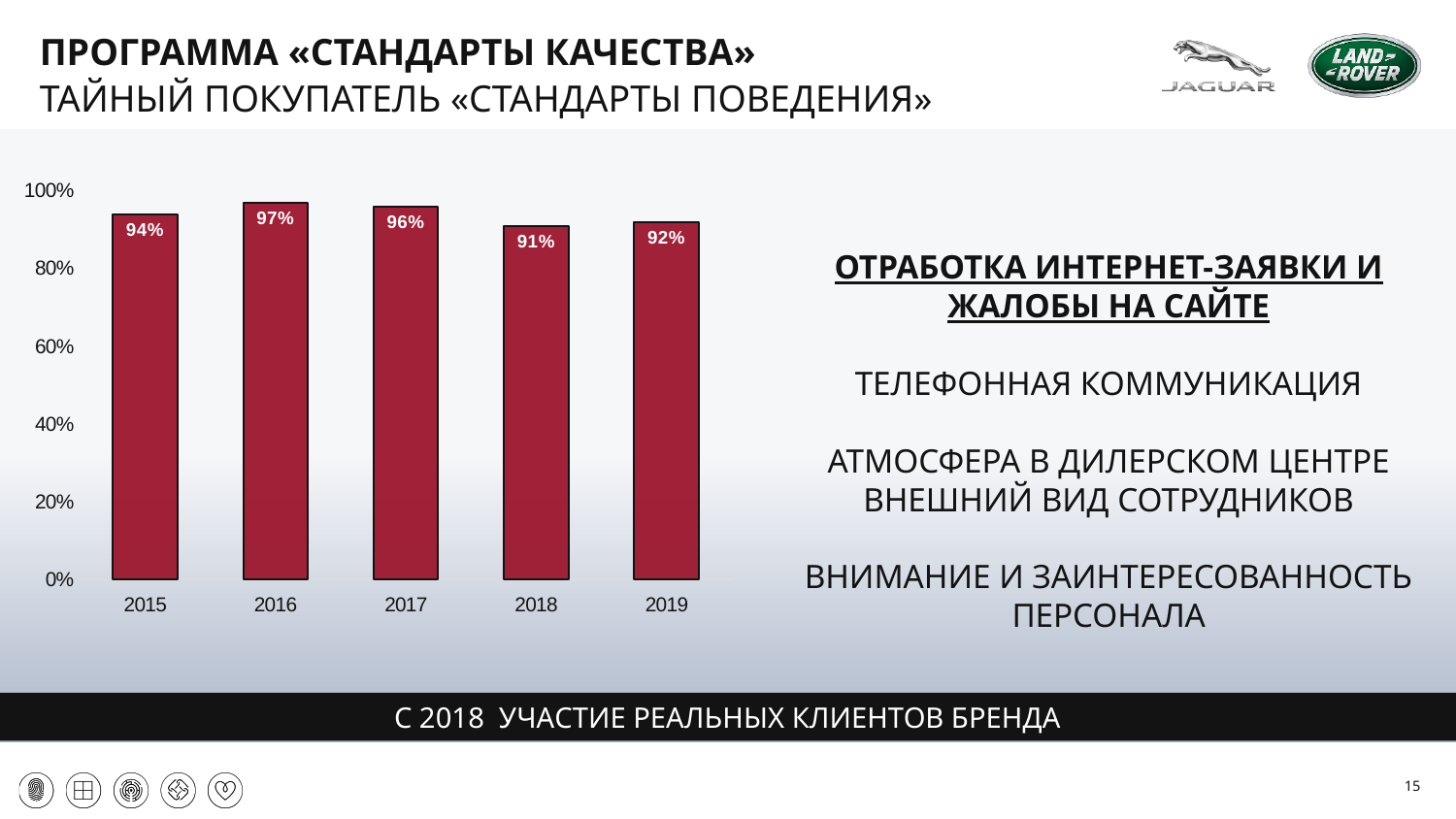
What is the value for 2018? 91% What is the difference between the values for 2015 and 2017? 2% What is the value for 2019? 92% Which year has the lowest value? 2018 Do the values rise or fall from 2017 to 2018? fall What kind of chart is shown on the slide? bar chart What is the difference between the values for 2016 and 2018? 6% What is the value for 2015? 94% Is the value for 2018 greater or less than 80%? greater How many years are shown on the x axis? 5 Which is larger, the value for 2017 or the value for 2019? 2017 Which year has the highest value? 2016